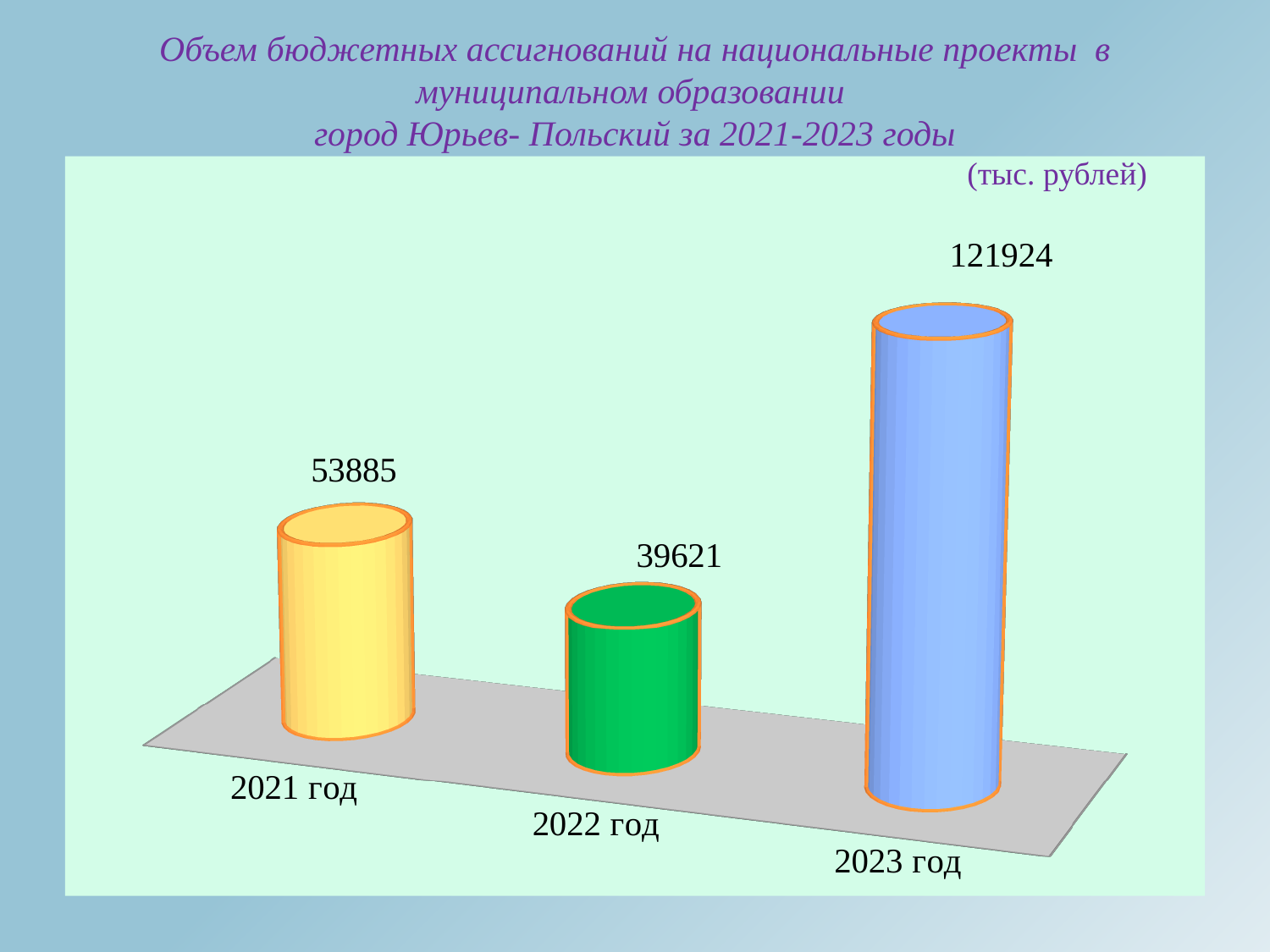
What unit is stated for the values on the chart? тыс. рублей What is the value for 2022 год? 39621 What is the value for 2021 год? 53885 Which is larger, the value for 2021 год or the value for 2022 год? 2021 год What kind of chart is this? bar chart What is the difference between the values for 2023 год and 2021 год? 68039 What is the value for 2023 год? 121924 How many years are shown on the chart? 3 What is the difference between the values for 2021 год and 2022 год? 14264 What colour is the bar for 2023 год? blue Which year has the highest value? 2023 год Which year has the lowest value? 2022 год